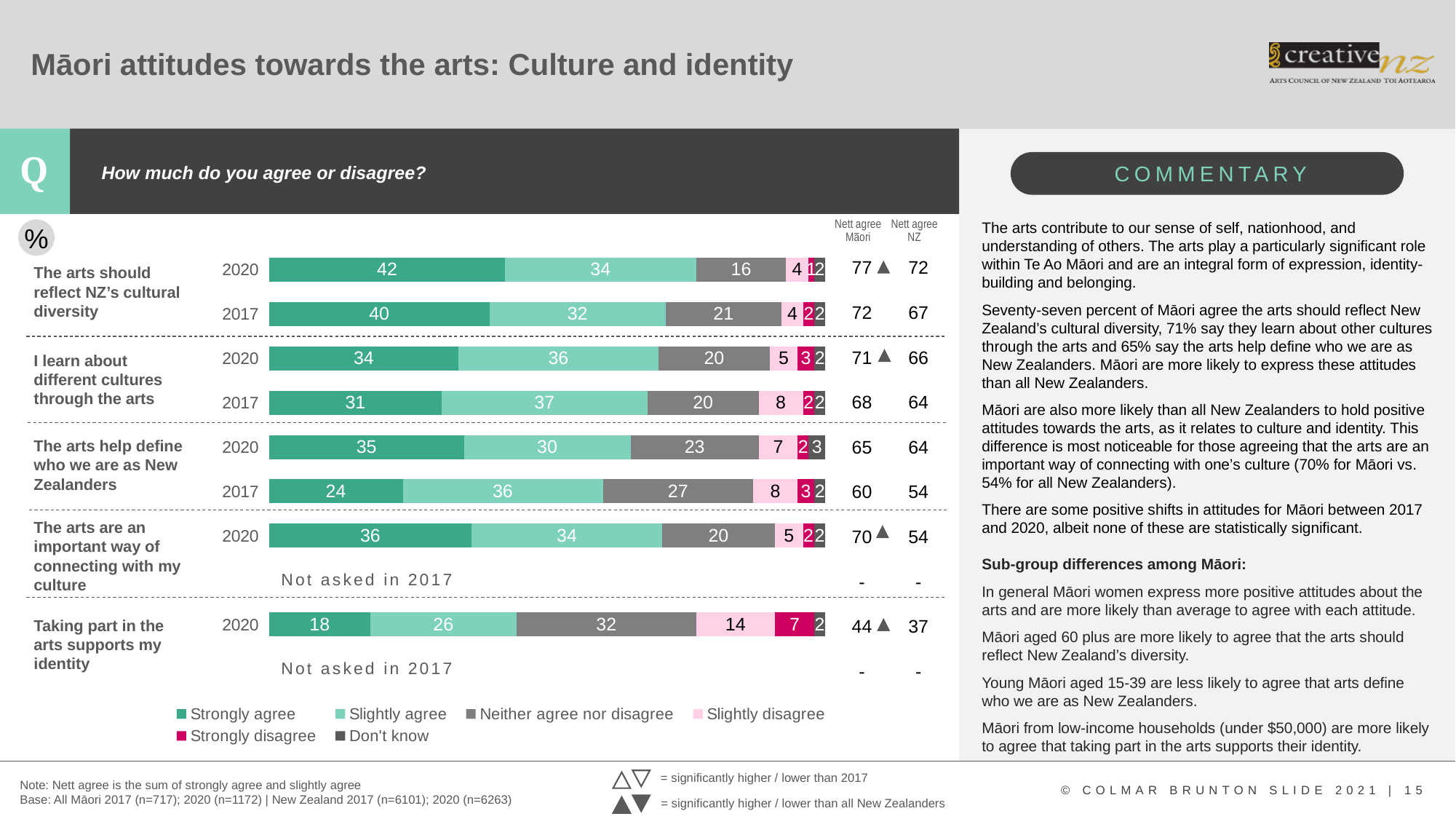
How many series does the legend list? 6 Which is larger: the 'Strongly agree' value for 'The arts help define who we are as New Zealanders' in 2020 or in 2017? 2020 What is the Nett agree Māori figure for 'The arts are an important way of connecting with my culture' in 2020? 70 What is the 'Neither agree nor disagree' value for 'Taking part in the arts supports my identity' in 2020? 32 What percentage of Māori strongly agreed in 2020 that the arts should reflect NZ's cultural diversity? 42 What is the Nett agree NZ figure for 'The arts help define who we are as New Zealanders' in 2017? 54 Which statement has the lowest Nett agree Māori figure in 2020? Taking part in the arts supports my identity What kind of chart is shown on the slide? Stacked bar chart Which statement has the highest Nett agree Māori figure in 2020? The arts should reflect NZ's cultural diversity What colour represents 'Strongly disagree' in the legend? Magenta/pink How many statements were not asked in 2017? 2 What is the difference between the Nett agree Māori and Nett agree NZ figures for 'The arts are an important way of connecting with my culture' in 2020? 16